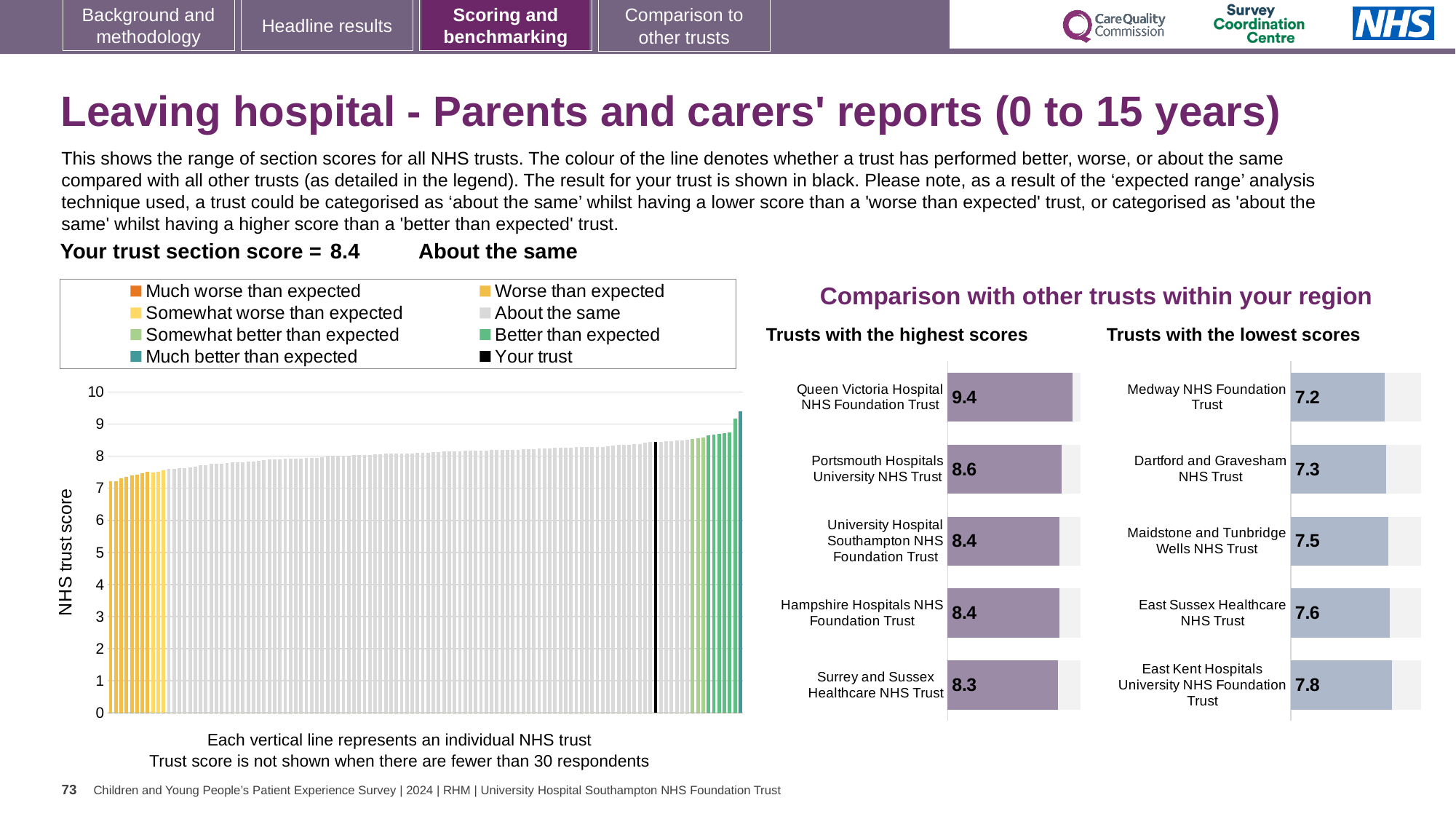
In the 'Trusts with the lowest scores' chart, what is the score for Medway NHS Foundation Trust? 7.2 What kind of chart is the 'NHS trust score' chart on the left of the slide? Bar chart In the 'NHS trust score' chart on the left, what colour represents 'Your trust' according to the legend? Black In the 'NHS trust score' chart on the left, do the values rise or fall from left to right? Rise In the 'Trusts with the highest scores' chart, what is the score for Queen Victoria Hospital NHS Foundation Trust? 9.4 In the 'Trusts with the highest scores' chart, what is the difference between the scores of Queen Victoria Hospital NHS Foundation Trust and Portsmouth Hospitals University NHS Trust? 0.8 In the 'Trusts with the lowest scores' chart, what is the difference between the scores of East Kent Hospitals University NHS Foundation Trust and Medway NHS Foundation Trust? 0.6 In the 'Trusts with the lowest scores' chart, which trust has the lowest score? Medway NHS Foundation Trust How many trusts are shown in the 'Trusts with the highest scores' chart? 5 In the 'Trusts with the highest scores' chart, which trust has the highest score? Queen Victoria Hospital NHS Foundation Trust How many entries does the legend of the NHS trust score chart on the left list? 8 In the 'Trusts with the lowest scores' chart, which has the larger score: Maidstone and Tunbridge Wells NHS Trust or Dartford and Gravesham NHS Trust? Maidstone and Tunbridge Wells NHS Trust